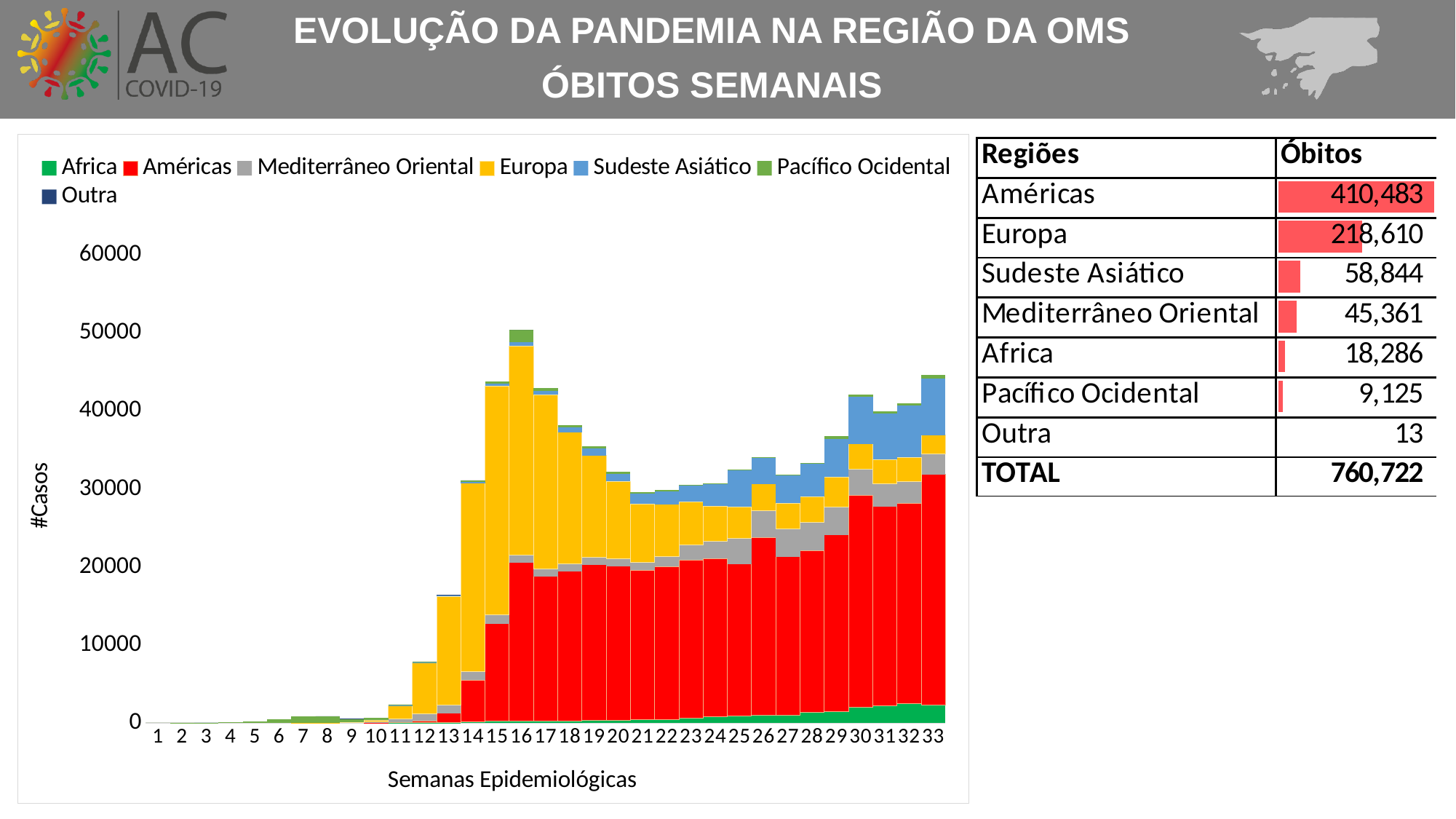
Which colour represents the Américas series in the chart legend? Red Which epidemiological week has the highest total stacked bar in the chart? 16 Do the total stacked bar values rise or fall from week 16 to week 21? Fall Is the total value of the stacked bar for week 16 greater or less than 40000? greater What kind of chart is shown on the slide? Stacked bar chart Is the total value of the stacked bar for week 12 greater or less than 10000? less How many epidemiological weeks are plotted along the x axis of the chart? 33 How many series does the chart legend list? 7 Which stacked bar is taller in the chart, week 16 or week 20? Week 16 What is the title of the x axis of the chart? Semanas Epidemiológicas Is the total value of the stacked bar for week 13 greater or less than 10000? greater